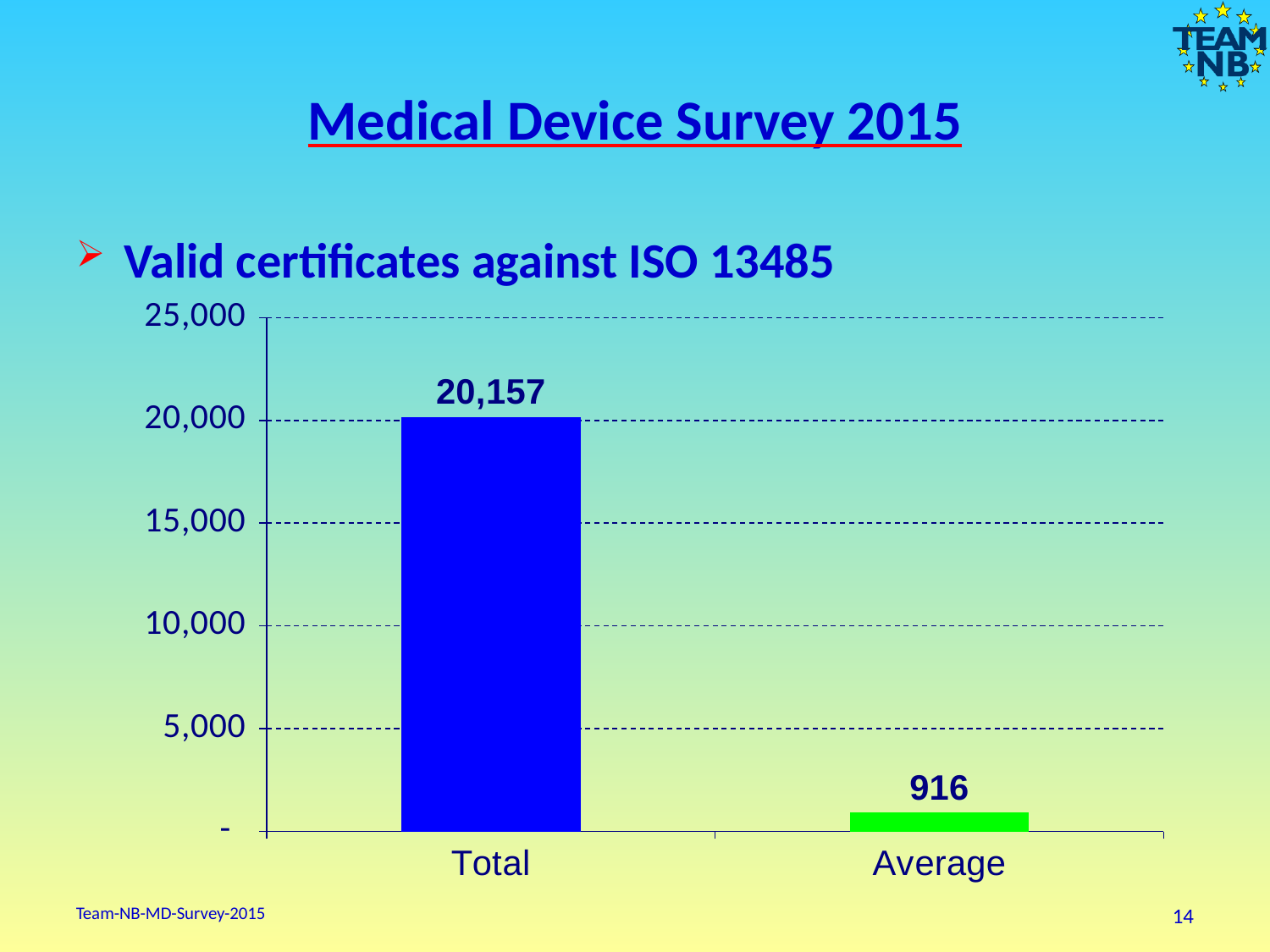
What is the value of the Average bar? 916 Which is larger, the Total value or the Average value? Total What is the difference between the Total and Average values? 19,241 What kind of chart is shown on the slide? bar chart How many categories are shown on the chart? 2 What is the value of the Total bar? 20,157 Is the value for Total greater or less than 20,000? greater Which category has the lowest value? Average Is the value for Average greater or less than 5,000? less What colour is the Average bar? green What is the heading above the chart? Valid certificates against ISO 13485 Which category has the highest value? Total